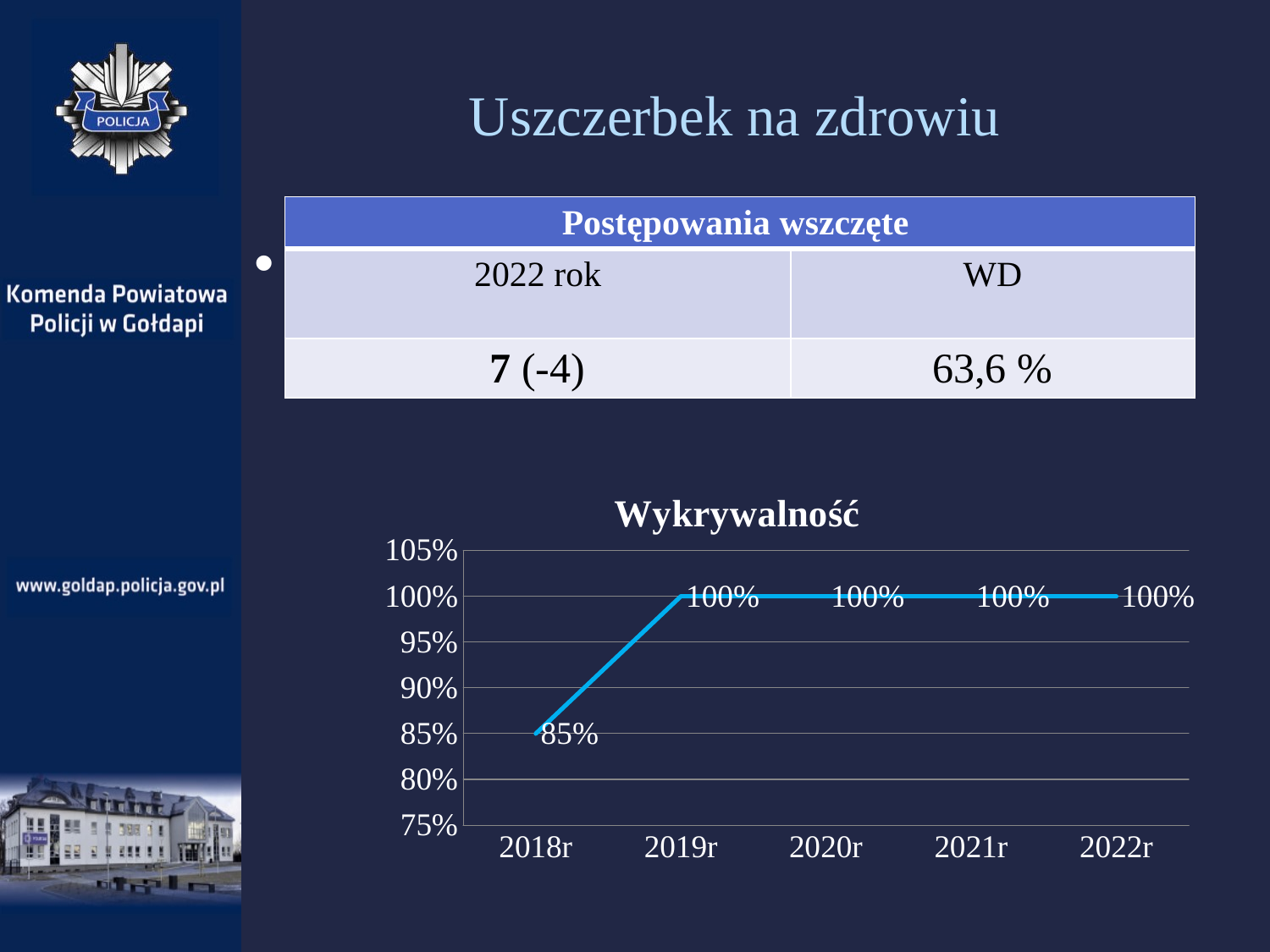
What is the value for 2019r in the Wykrywalność chart? 100% What is the title of the chart on the slide? Wykrywalność How many years are plotted on the x axis of the Wykrywalność chart? 5 What is the value for 2018r in the Wykrywalność chart? 85% What is the difference between the values for 2019r and 2018r in the Wykrywalność chart? 15% What is the value for 2022r in the Wykrywalność chart? 100% Is the value for 2018r in the Wykrywalność chart greater or less than 90%? less Which is larger in the Wykrywalność chart, the value for 2018r or the value for 2020r? 2020r Which year has the lowest value in the Wykrywalność chart? 2018r What is the highest value shown on the y axis of the Wykrywalność chart? 105% What kind of chart is the Wykrywalność chart? line chart Do the values in the Wykrywalność chart rise or fall from 2018r to 2019r? rise